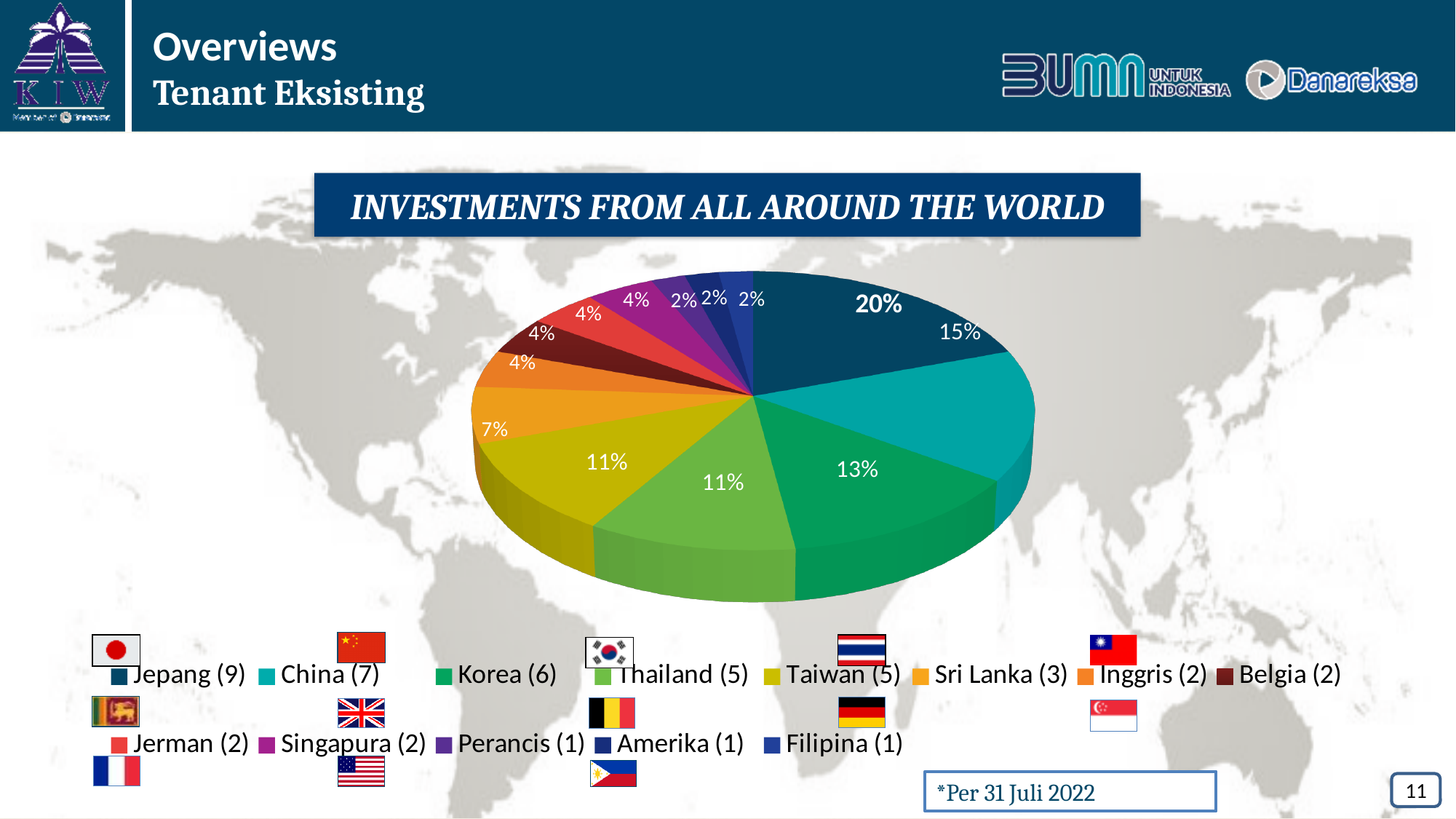
What percentage of the pie does Korea account for? 13% What is the title shown above the pie chart? INVESTMENTS FROM ALL AROUND THE WORLD Which has a larger share of the pie, Korea or Sri Lanka? Korea What percentage of the pie does Sri Lanka account for? 7% What is the difference in percentage points between Jepang's share and China's share? 5 How many tenants does the legend show for Jepang? 9 Which country has the largest share of the pie chart? Jepang What date is the data on the slide reported as of? 31 Juli 2022 What percentage of the pie does China account for? 15% How many countries (slices) does the pie chart legend list? 13 What kind of chart is shown on the slide? pie chart What percentage of the pie does Jepang account for? 20%